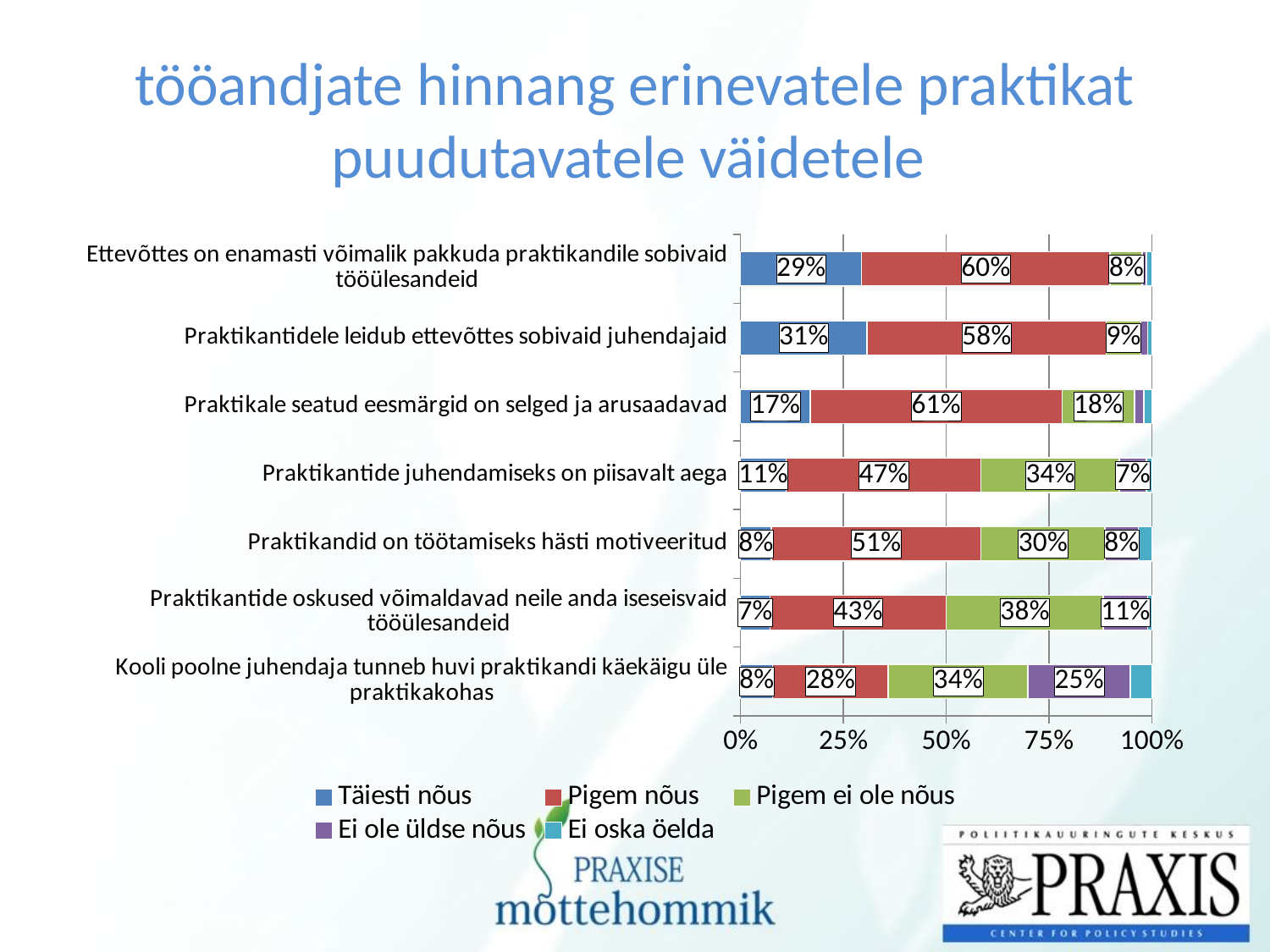
What is the 'Pigem ei ole nõus' value for 'Praktikantide oskused võimaldavad neile anda iseseisvaid tööülesandeid'? 38% Which statement has the lowest 'Täiesti nõus' share? Praktikantide oskused võimaldavad neile anda iseseisvaid tööülesandeid What is the 'Ei ole üldse nõus' value for 'Kooli poolne juhendaja tunneb huvi praktikandi käekäigu üle praktikakohas'? 25% Which legend entry is shown in red? Pigem nõus How many series does the legend list? 5 What is the 'Pigem nõus' value for 'Praktikale seatud eesmärgid on selged ja arusaadavad'? 61% What kind of chart is shown on the slide? stacked bar chart How many statements (categories) are plotted in the chart? 7 Which is larger: the 'Pigem ei ole nõus' value for 'Praktikantide juhendamiseks on piisavalt aega' or for 'Praktikandid on töötamiseks hästi motiveeritud'? Praktikantide juhendamiseks on piisavalt aega Which statement has the highest 'Täiesti nõus' share? Praktikantidele leidub ettevõttes sobivaid juhendajaid What is the difference between the 'Pigem nõus' values for 'Ettevõttes on enamasti võimalik pakkuda praktikandile sobivaid tööülesandeid' (60%) and 'Kooli poolne juhendaja tunneb huvi praktikandi käekäigu üle praktikakohas' (28%)? 32% What is the 'Täiesti nõus' value for 'Praktikantidele leidub ettevõttes sobivaid juhendajaid'? 31%